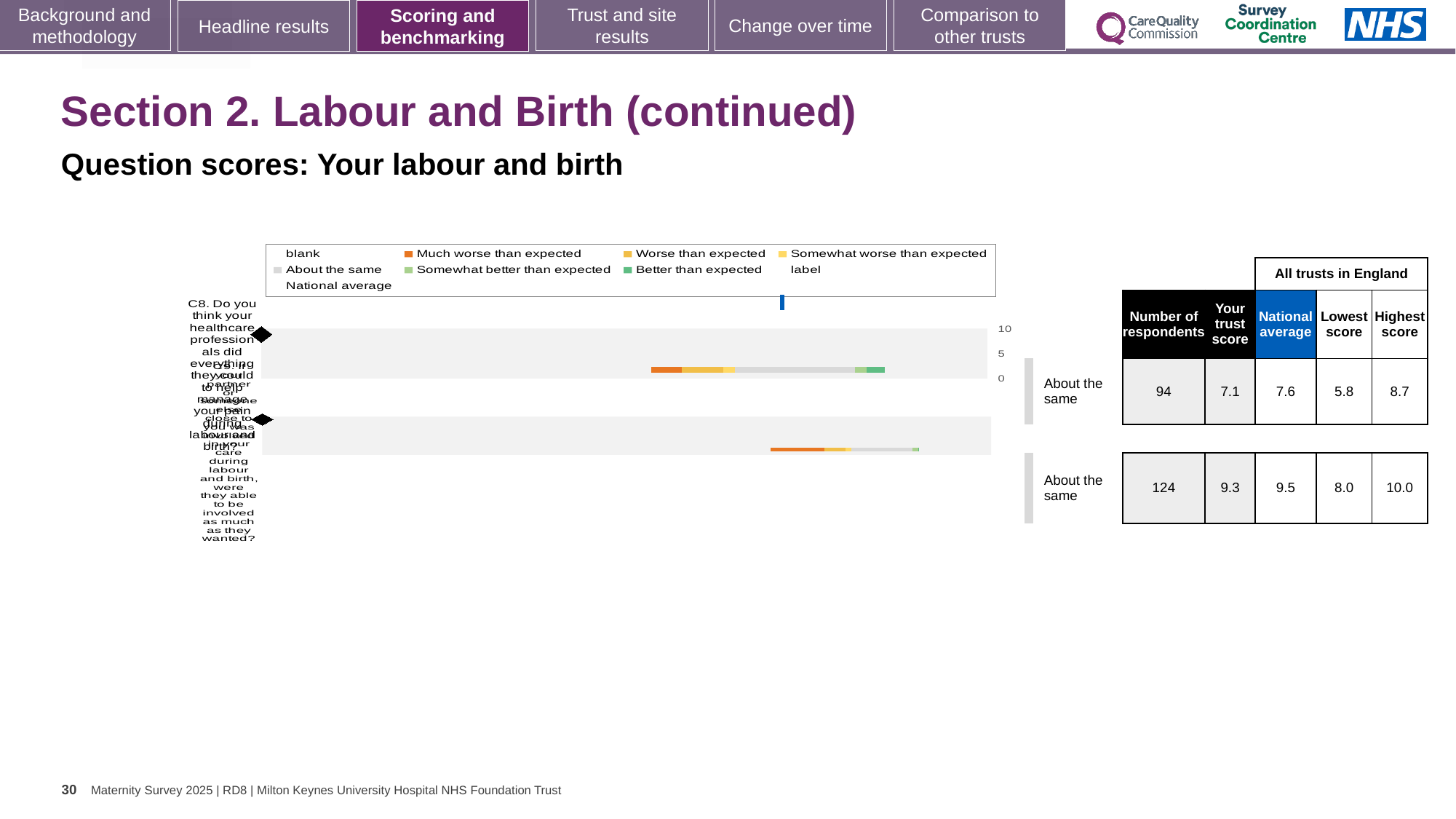
In the table beside the chart, what is the number of respondents for question C8? 94 How many entries does the chart's legend list? 9 In the table beside the chart, what is the national average for question C8? 7.6 What kind of chart is shown on the slide? bar chart What is the heading printed above the chart? Question scores: Your labour and birth In the table beside the chart, what is the highest score for the second question row? 10.0 Which legend entry is shown in orange? Much worse than expected For question C8, is the trust score higher or lower than the national average? lower For question C8, what is the difference between the highest score and the lowest score in the table? 2.9 How many question bars are plotted in the chart? 2 In the table beside the chart, what is the number of respondents for the second question row? 124 In the table beside the chart, what is the trust score for question C8? 7.1